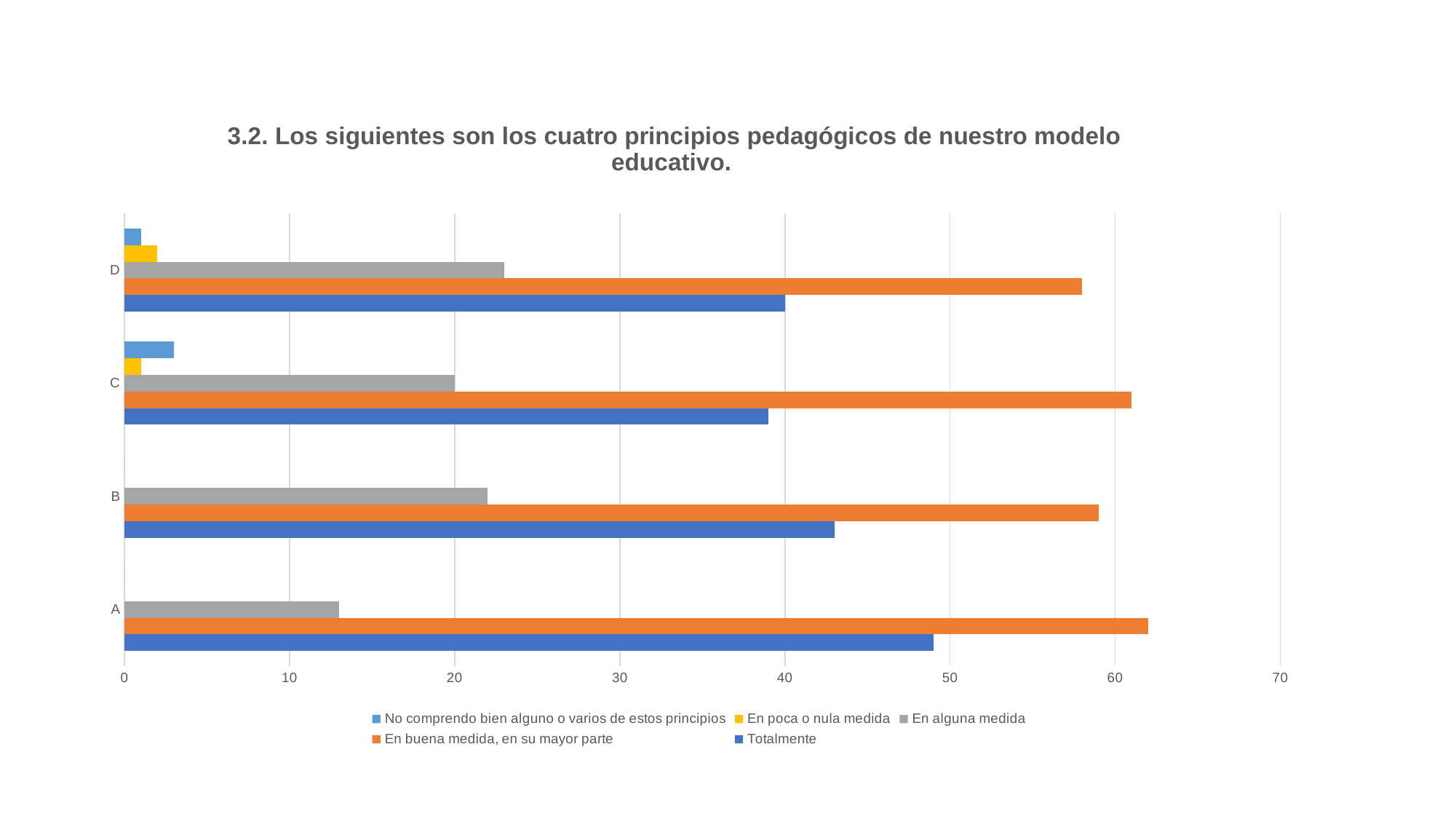
For category A, which is larger: 'Totalmente' or 'En buena medida, en su mayor parte'? En buena medida, en su mayor parte What kind of chart is shown on the slide? bar chart Is the value of 'En buena medida, en su mayor parte' for category A greater or less than 60? greater Which category has the lowest value for 'En alguna medida'? A Is the value of 'Totalmente' for category B greater or less than 40? greater How many categories are shown on the vertical axis of the chart? 4 Which series is shown in orange in the legend? En buena medida, en su mayor parte Is the value of 'En alguna medida' for category A greater or less than 20? less Which is larger: 'En alguna medida' for category B or for category A? B How many series does the legend list? 5 Which category has the highest value for 'Totalmente'? A